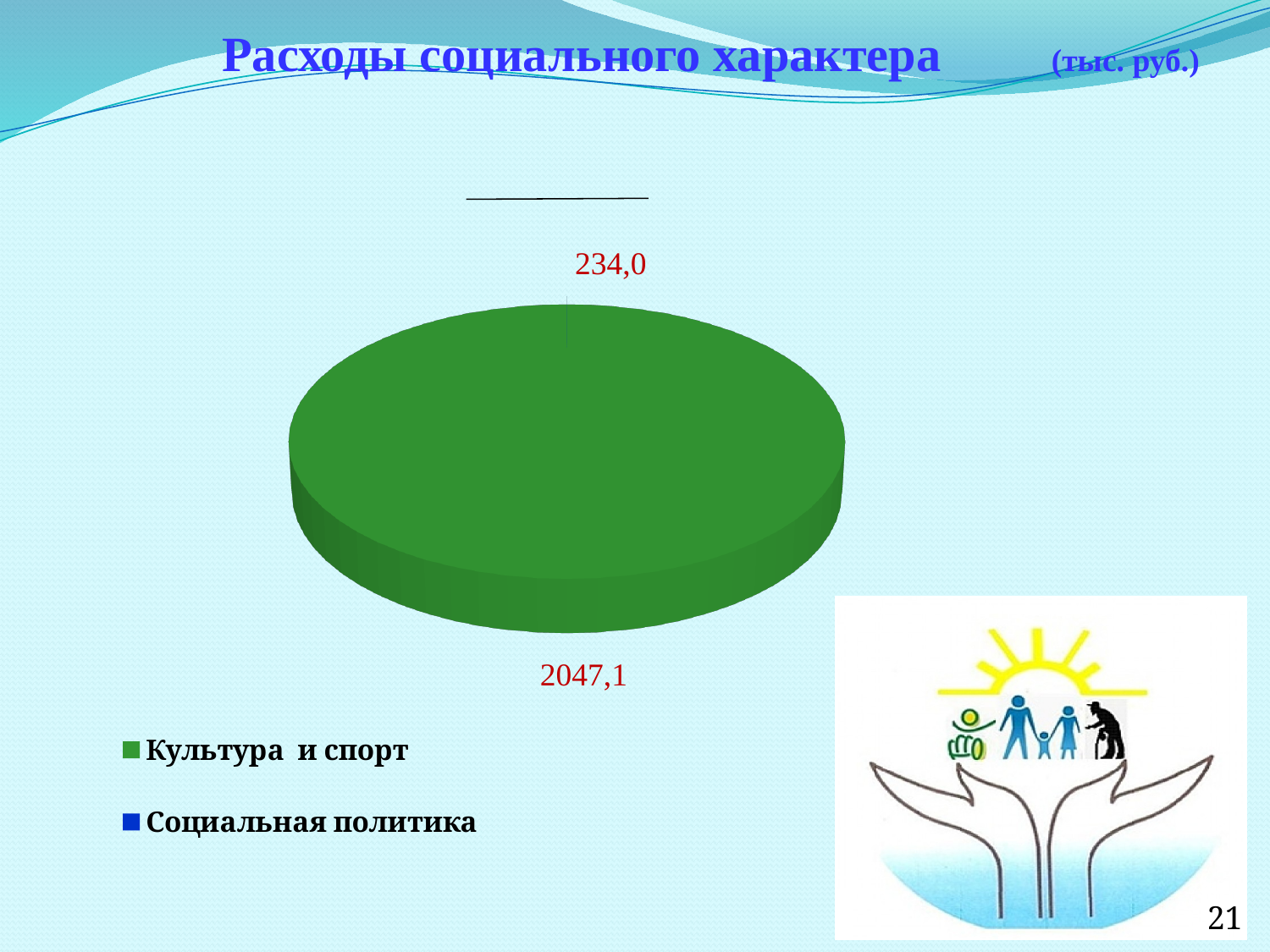
What value is labelled for Социальная политика? 234,0 What kind of chart is shown on the slide? pie chart Which category does the green slice of the pie chart represent? Культура и спорт What value is labelled for the green slice (Культура и спорт)? 2047,1 What is the difference between the two values labelled on the pie chart, 2047,1 and 234,0? 1813,1 What is the smaller of the two values labelled on the pie chart? 234,0 What is the total of the two values labelled on the pie chart? 2281,1 In what units are the values on the chart given? тыс. руб. Which is larger: the value 2047,1 or the value 234,0 on the pie chart? 2047,1 What is the title of the chart? Расходы социального характера (тыс. руб.) How many categories does the legend of the pie chart list? 2 What is the larger of the two values labelled on the pie chart? 2047,1